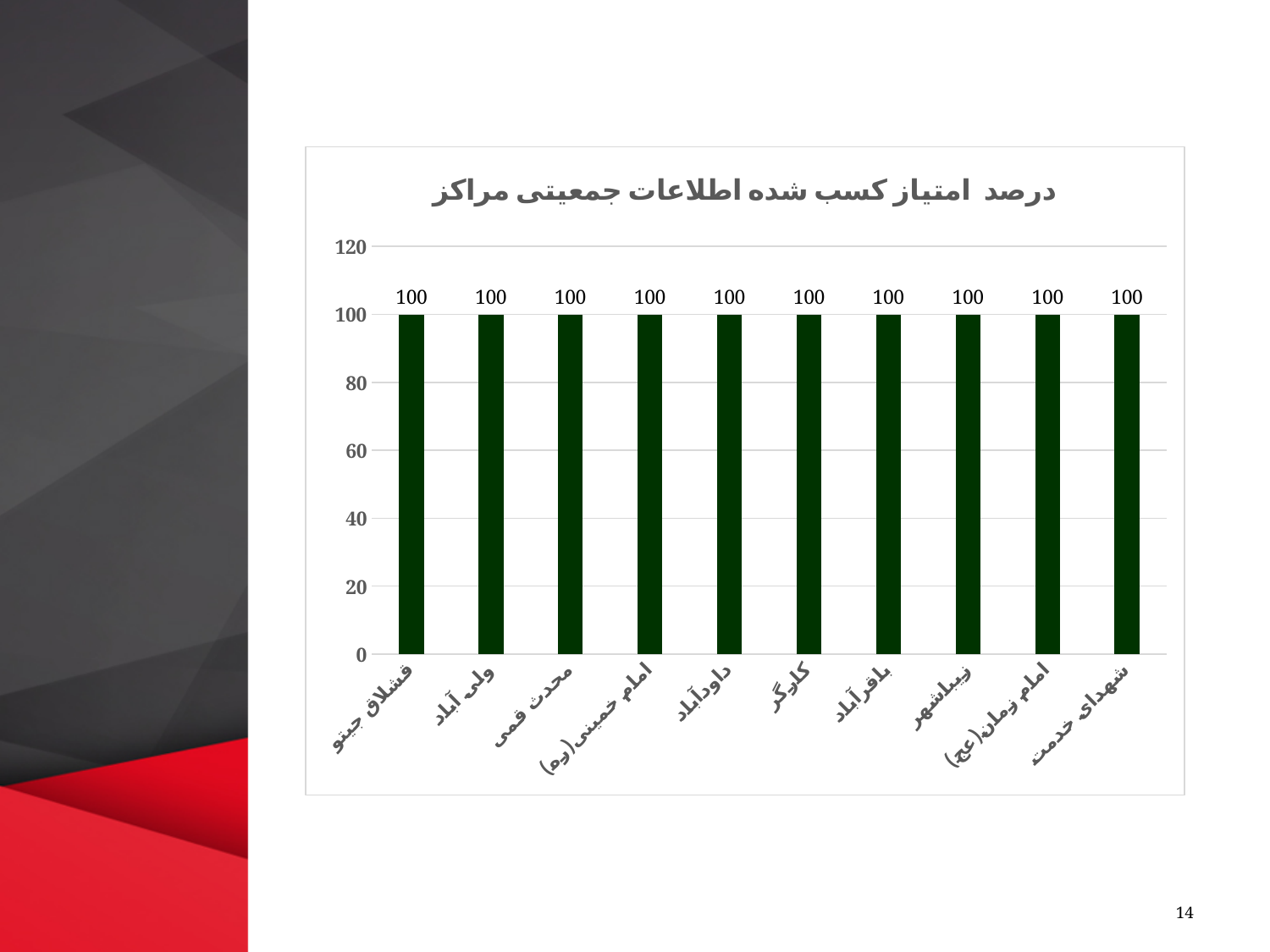
Is the value for باقرآباد greater or less than 80? greater What is the title of the chart? درصد امتیاز کسب شده اطلاعات جمعیتی مراکز What is the value for کارگر? 100 What is the value for امام زمان(عج)? 100 What kind of chart is this? bar chart What is the value for قشلاق جیتو? 100 Do the values rise, fall, or stay the same across the categories? stay the same What is the highest value shown on the y axis? 120 How many categories are shown on the x axis? 10 What is the value for زیباشهر? 100 What is the value for شهدای خدمت? 100 What is the difference between the values for ولی آباد and داودآباد? 0